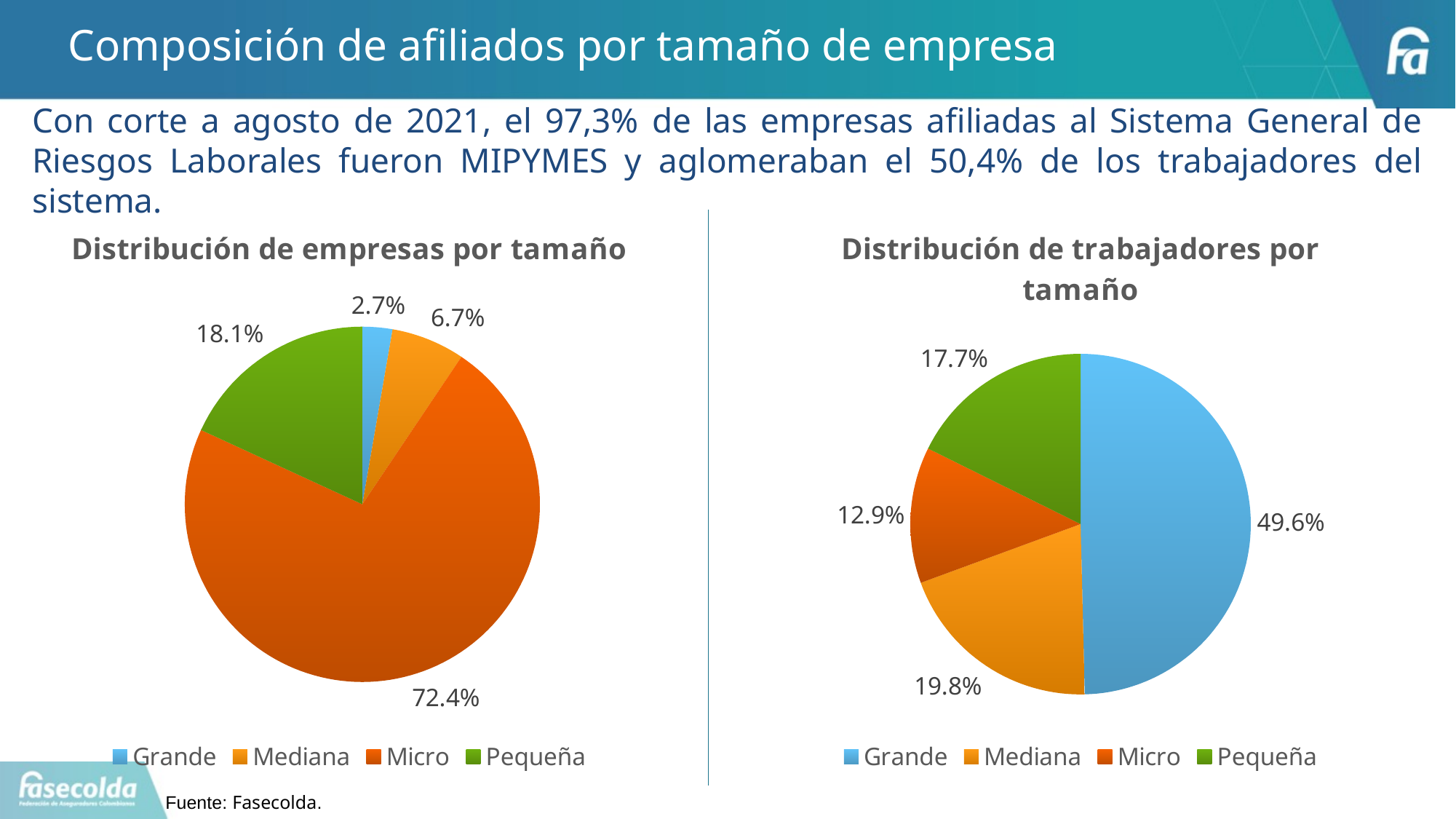
In the chart 'Distribución de trabajadores por tamaño', what share of workers are in Mediana companies? 19.8% In the chart 'Distribución de empresas por tamaño', what is the difference between the Pequeña and Mediana shares? 11.4% In the chart 'Distribución de empresas por tamaño', which category has the largest slice? Micro In the chart 'Distribución de trabajadores por tamaño', which category has the smallest slice? Micro In the chart 'Distribución de trabajadores por tamaño', what is the combined share of Mediana, Micro and Pequeña companies? 50.4% In the chart 'Distribución de empresas por tamaño', what share of companies are Micro? 72.4% In the chart 'Distribución de trabajadores por tamaño', which is larger, the Pequeña slice or the Micro slice? Pequeña In the chart 'Distribución de empresas por tamaño', what colour is the Pequeña slice? Green In the chart 'Distribución de empresas por tamaño', what share of companies are Grande? 2.7% In the chart 'Distribución de trabajadores por tamaño', what share of workers are in Grande companies? 49.6% How many categories does the legend of the chart 'Distribución de empresas por tamaño' list? 4 What kind of chart is 'Distribución de trabajadores por tamaño'? Pie chart